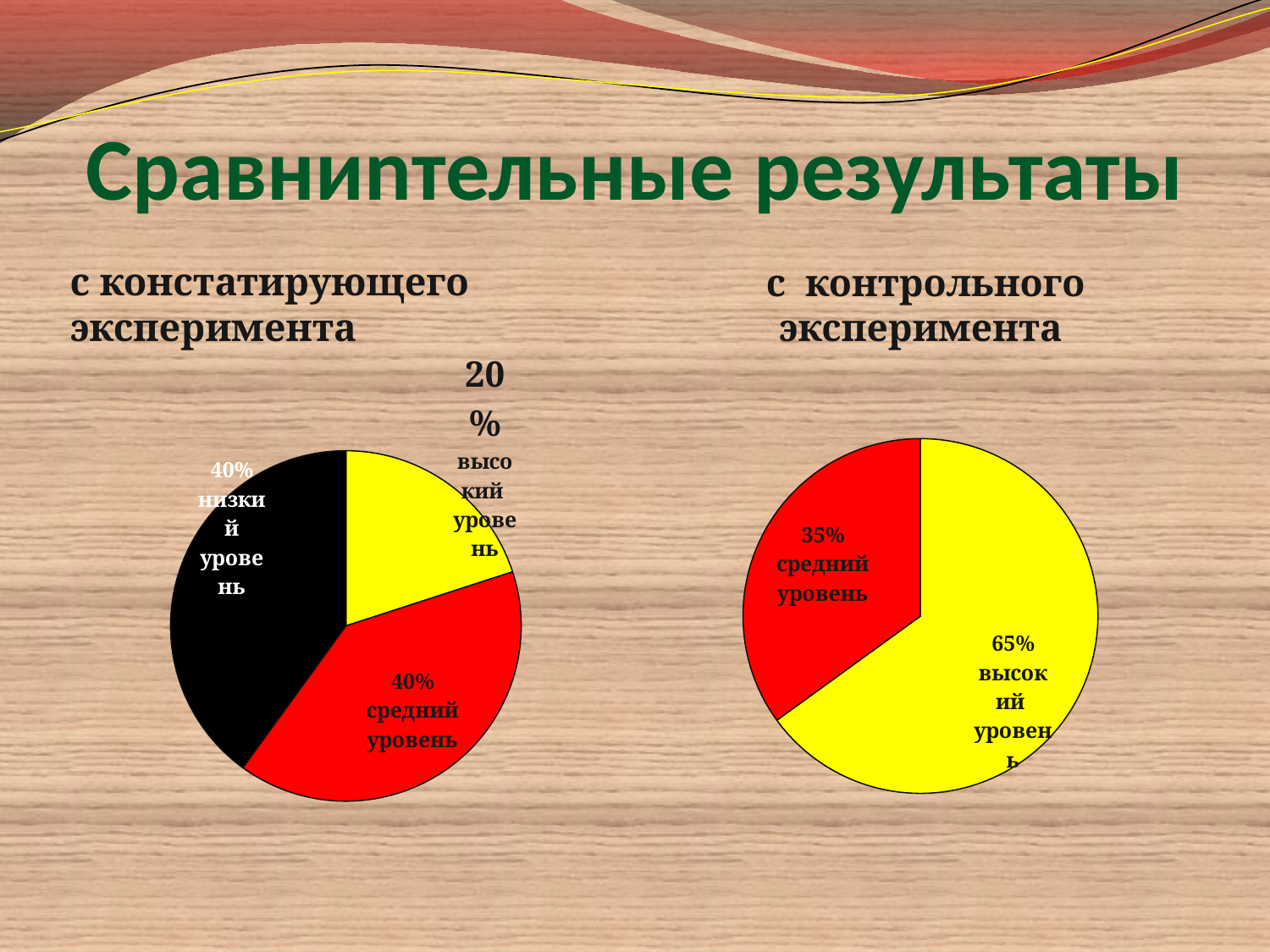
What kind of chart is shown on the left under 'с констатирующего эксперимента'? pie chart In the left pie chart ('с констатирующего эксперимента'), what colour is the 'низкий уровень' slice? black In the right pie chart ('с контрольного эксперимента'), what is the difference between the 'высокий уровень' and 'средний уровень' shares? 30% In the right pie chart ('с контрольного эксперимента'), what share is labelled 'средний уровень'? 35% In the left pie chart ('с констатирующего эксперимента'), what share is labelled 'высокий уровень'? 20% In the left pie chart ('с констатирующего эксперимента'), what share is labelled 'низкий уровень'? 40% How many slices does the left pie chart ('с констатирующего эксперимента') have? 3 How many slices does the right pie chart ('с контрольного эксперимента') have? 2 In the left pie chart ('с констатирующего эксперимента'), what share is labelled 'средний уровень'? 40% In the left pie chart ('с констатирующего эксперимента'), which level has the smallest share? высокий уровень In the right pie chart ('с контрольного эксперимента'), which level has the largest share? высокий уровень In the right pie chart ('с контрольного эксперимента'), what share is labelled 'высокий уровень'? 65%